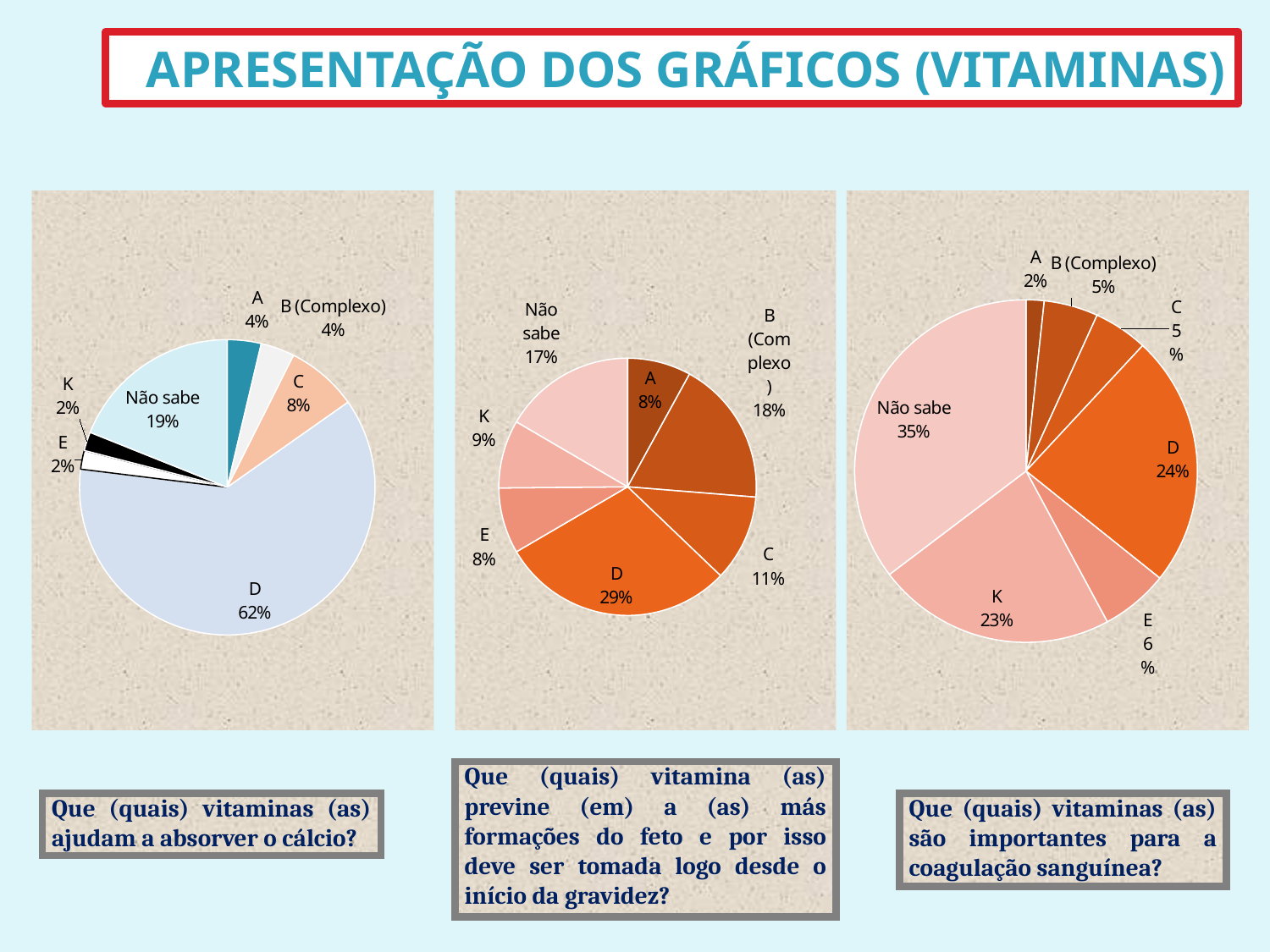
What kind of chart is the left chart? Pie chart In the left pie chart, what is the value for D? 62% In the right pie chart, which category has the smallest slice? A In the right pie chart, which category has the largest slice? Não sabe In the left pie chart, how many slices are there? 7 In the middle pie chart, which category has the largest slice? D In the middle pie chart, what is the difference between D and C? 18% In the middle pie chart, which is larger, K or E? K In the middle pie chart, what is the value for B (Complexo)? 18% In the right pie chart, what is the value for K? 23% In the left pie chart, what is the value for Não sabe? 19% In the left pie chart, which category has the largest slice? D